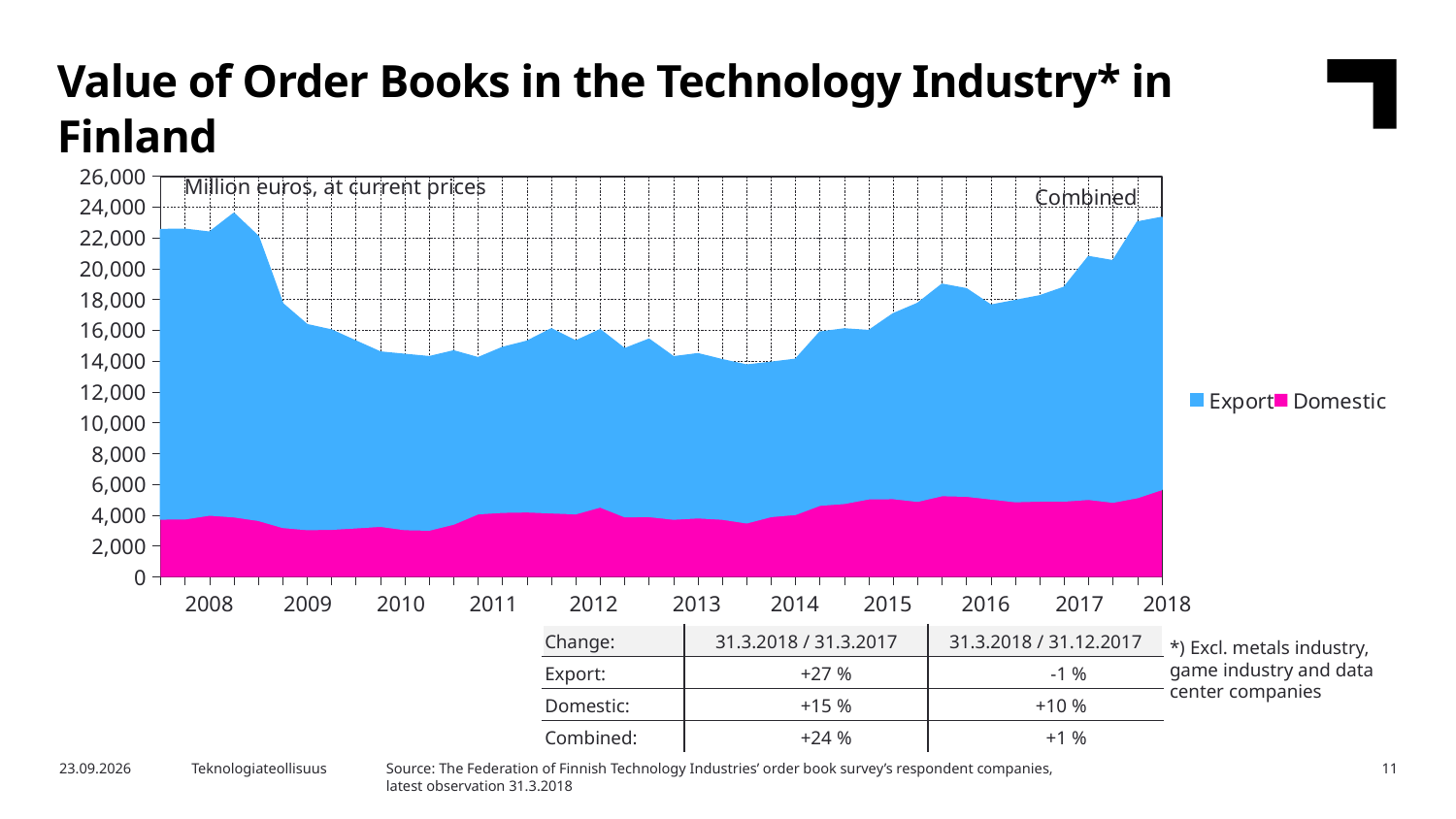
Which two series are listed in the chart's legend? Export and Domestic How many series does the chart's legend list? 2 Is the combined value of order books at the start of 2008 greater or less than 20,000? greater How many year labels are shown on the x axis? 11 Is the Domestic value at 2010 greater or less than 4,000? less What kind of chart is shown on the slide? Stacked area chart Which series is larger throughout the chart, Export or Domestic? Export Is the combined value of order books at 2018 greater or less than 22,000? greater What unit label is shown inside the chart area? Million euros, at current prices Does the combined value of order books rise or fall between 2014 and 2018? rise